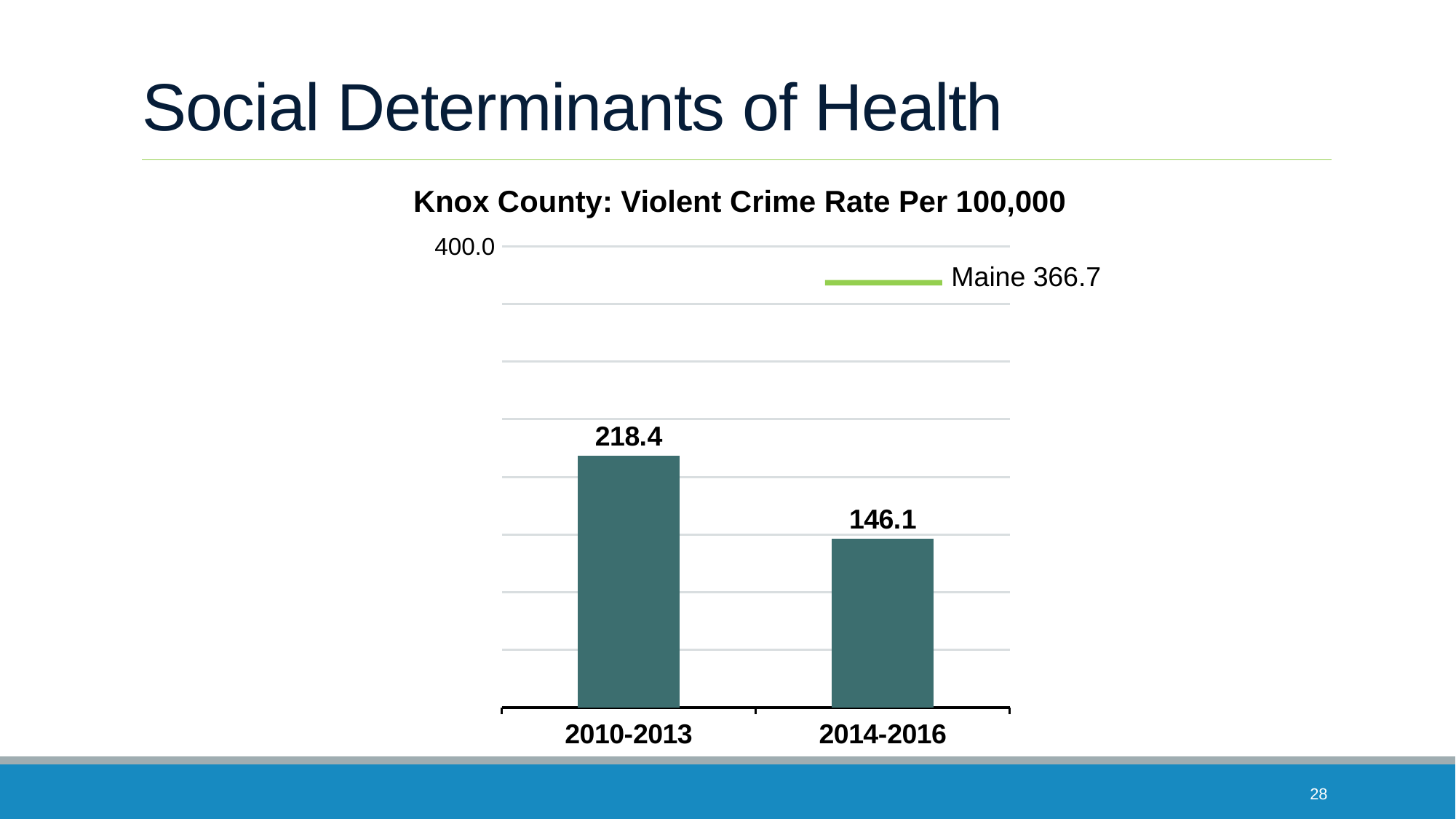
By how much did the Knox County violent crime rate fall from 2010-2013 to 2014-2016? 72.3 Which period has the higher violent crime rate in Knox County? 2010-2013 Is the Knox County violent crime rate higher in 2010-2013 or in 2014-2016? 2010-2013 How many time periods are shown on the chart? 2 What is the Maine violent crime rate per 100,000 shown as the reference line? 366.7 What is the violent crime rate per 100,000 for Knox County in 2014-2016? 146.1 What is the violent crime rate per 100,000 for Knox County in 2010-2013? 218.4 Which period has the lower violent crime rate in Knox County? 2014-2016 Does the Knox County violent crime rate rise or fall from 2010-2013 to 2014-2016? Fall What kind of chart is used to show the Knox County violent crime rate? Bar chart What is the title of the chart? Knox County: Violent Crime Rate Per 100,000 What is the highest value shown on the vertical axis? 400.0